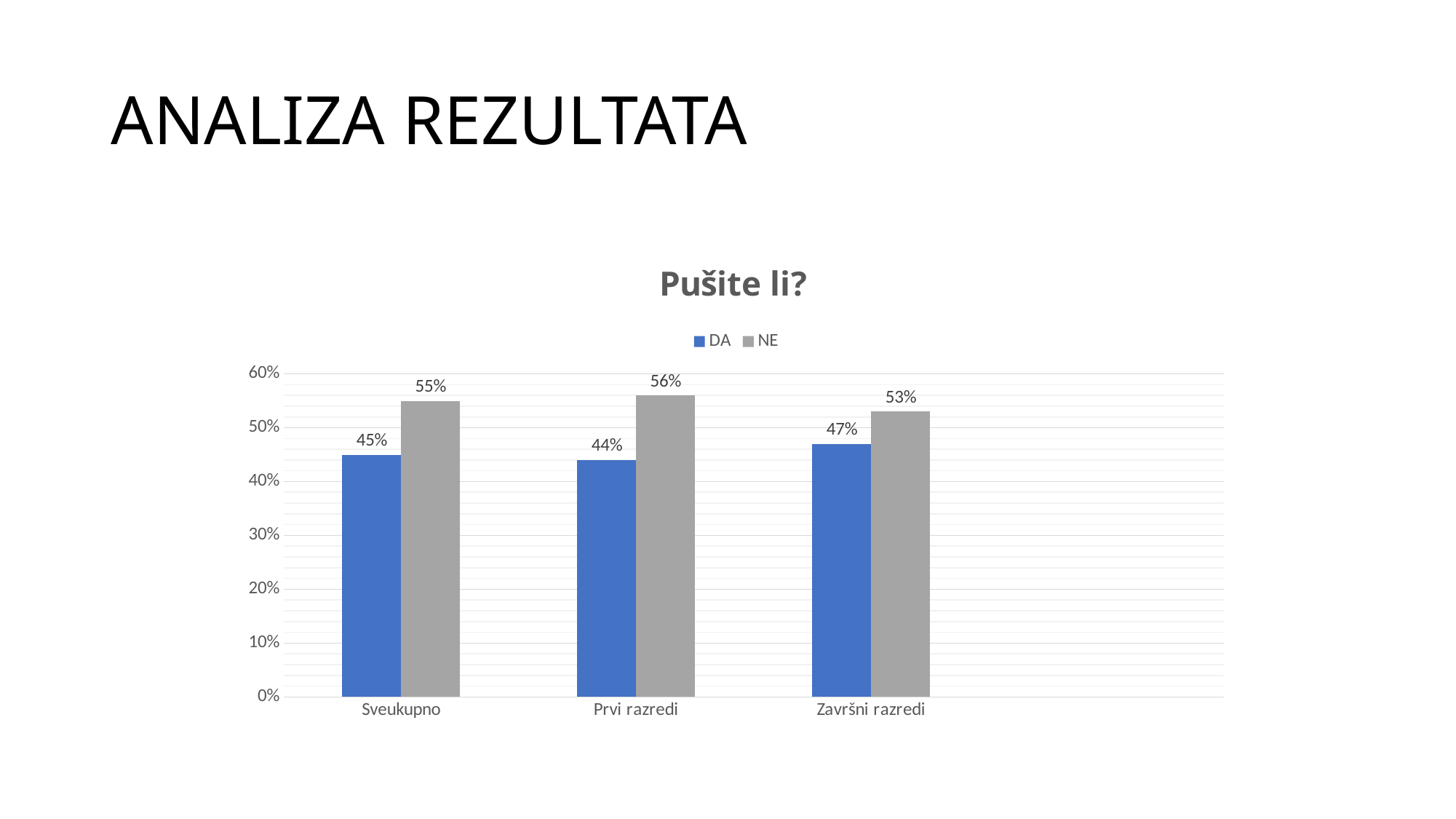
Which category has the highest NE value? Prvi razredi What is the difference between the NE and DA values for Sveukupno? 10% What is the DA value for Završni razredi? 47% What is the title of the chart? Pušite li? What is the NE value for Prvi razredi? 56% What is the DA value for Sveukupno? 45% Is the DA value for Prvi razredi greater or less than 50%? less How many categories are shown on the x axis? 3 Which is larger for Završni razredi, DA or NE? NE How many series does the legend list? 2 Which category has the lowest DA value? Prvi razredi What is the NE value for Završni razredi? 53%